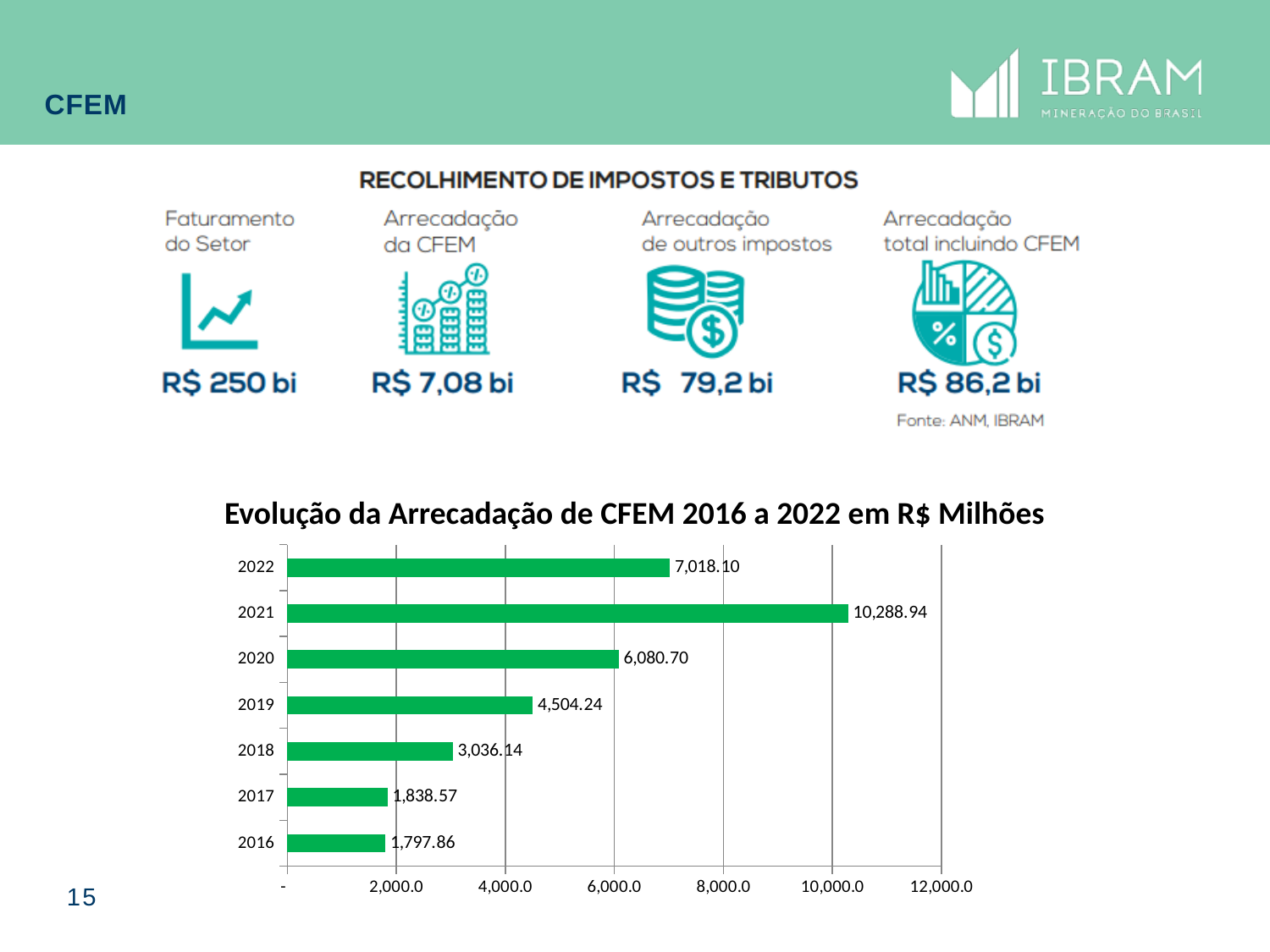
What is the difference between the values for 2021 and 2022 in the CFEM evolution chart? 3,270.84 How many years are shown in the CFEM evolution chart? 7 What kind of chart is used to show the evolution of CFEM collection from 2016 to 2022? Bar chart What is the value for 2016 in the CFEM evolution chart? 1,797.86 In the CFEM evolution chart, is the value for 2018 greater or less than 4,000.0? less Which year has the lowest value in the CFEM evolution chart? 2016 What is the difference between the values for 2020 and 2019 in the CFEM evolution chart? 1,576.46 What is the value for 2021 in the chart 'Evolução da Arrecadação de CFEM 2016 a 2022 em R$ Milhões'? 10,288.94 What is the value for 2019 in the CFEM evolution chart? 4,504.24 Which year has the highest value in the CFEM evolution chart? 2021 In the CFEM evolution chart, which is larger, the value for 2020 or the value for 2022? 2022 In the CFEM evolution chart, do the values rise or fall from 2016 to 2021? Rise